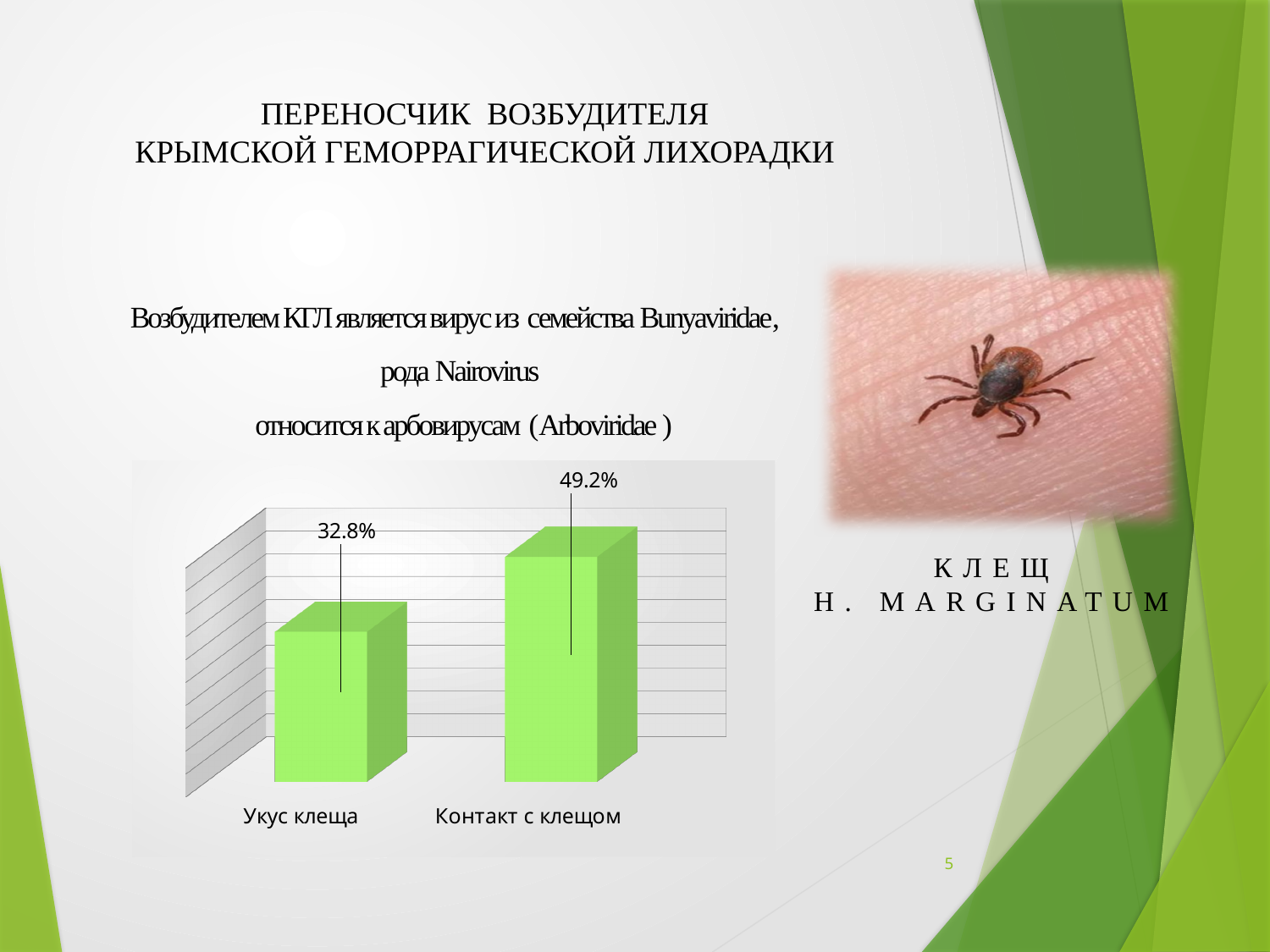
How many categories are shown in the chart? 2 What is the value for Укус клеща? 32.8% What is the difference between the values for Контакт с клещом and Укус клеща? 16.4% What is the value for Контакт с клещом? 49.2% Which category has the lowest value? Укус клеща Do the values rise or fall from left to right along the x axis? rise Which is larger, the value for Укус клеща or the value for Контакт с клещом? Контакт с клещом What kind of chart is shown on the slide? bar chart Are the bars in the chart vertical or horizontal? vertical What colour are the bars in the chart? green Which category has the highest value? Контакт с клещом